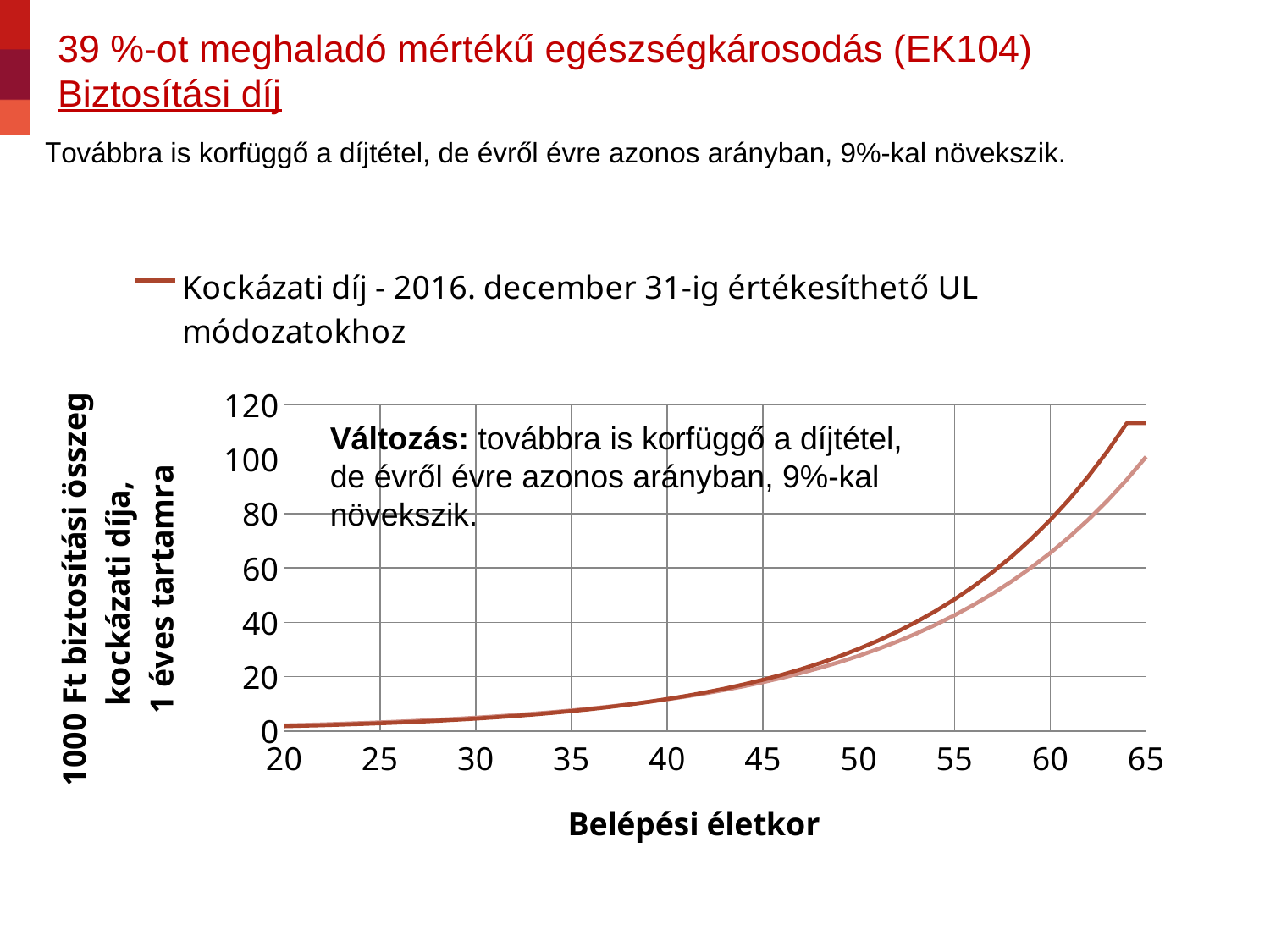
Is the value of the darker line at age 40 greater or less than 20? less What kind of chart is shown on the slide? line chart At age 60, which line has the higher value, the darker line or the lighter line? the darker line Is the value of the lighter line at age 55 greater or less than 60? less Is the value of the darker line at age 60 greater or less than 60? greater Do the plotted values rise or fall as the entry age (Belépési életkor) increases from 20 to 65? rise What is the legend entry shown above the chart? Kockázati díj - 2016. december 31-ig értékesíthető UL módozatokhoz What is the title of the x axis of the chart? Belépési életkor What is the highest value labelled on the y axis of the chart? 120 How many tick labels are shown on the x axis of the chart? 10